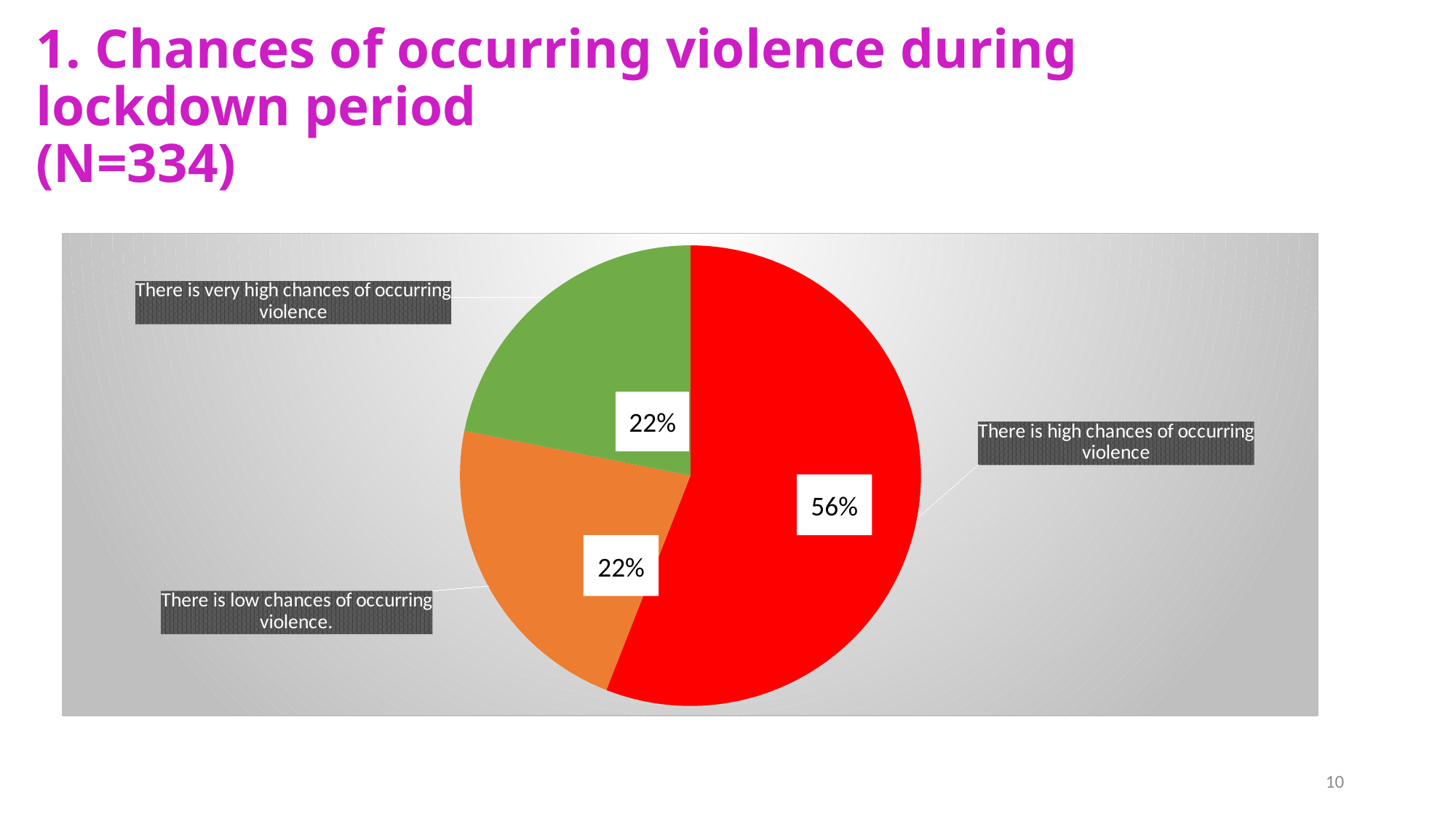
Is the share for 'There is high chances of occurring violence' greater or less than 50%? greater How many slices does the pie chart have? 3 What is the difference between the share for 'There is high chances of occurring violence' and 'There is low chances of occurring violence'? 34% What type of chart is shown on the slide? Pie chart What percentage is shown for 'There is high chances of occurring violence'? 56% What sample size (N) is stated in the slide title? 334 What colour is the slice for 'There is high chances of occurring violence'? Red Which category has the largest share of the pie? There is high chances of occurring violence Which is larger: the share for 'There is high chances of occurring violence' or 'There is very high chances of occurring violence'? There is high chances of occurring violence What percentage is shown for 'There is low chances of occurring violence'? 22% What percentage is shown for 'There is very high chances of occurring violence'? 22%